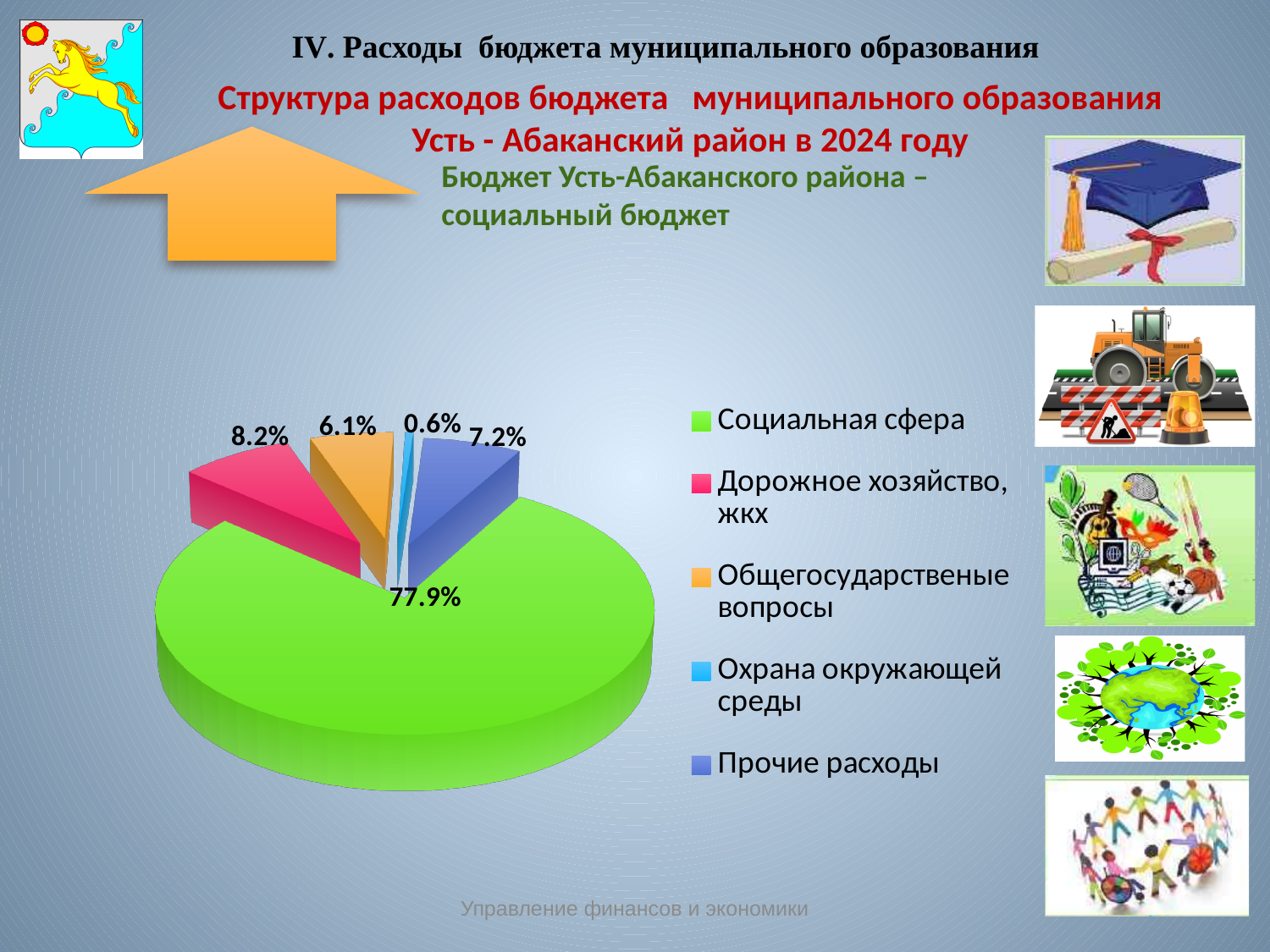
What is the value shown for Дорожное хозяйство, жкх? 8.2% Which category has the smallest share of the pie? Охрана окружающей среды How many categories does the pie chart have? 5 What is the value shown for Прочие расходы? 7.2% What type of chart is shown on the slide? pie chart Which category has the largest share of the pie? Социальная сфера Which is larger: the share of Прочие расходы or the share of Общегосударственые вопросы? Прочие расходы What is the value shown for Охрана окружающей среды? 0.6% What is the difference between the shares of Дорожное хозяйство, жкх and Прочие расходы? 1.0% What is the value shown for Общегосударственые вопросы? 6.1% What colour is the slice for Социальная сфера? green What share of the pie does Социальная сфера have? 77.9%